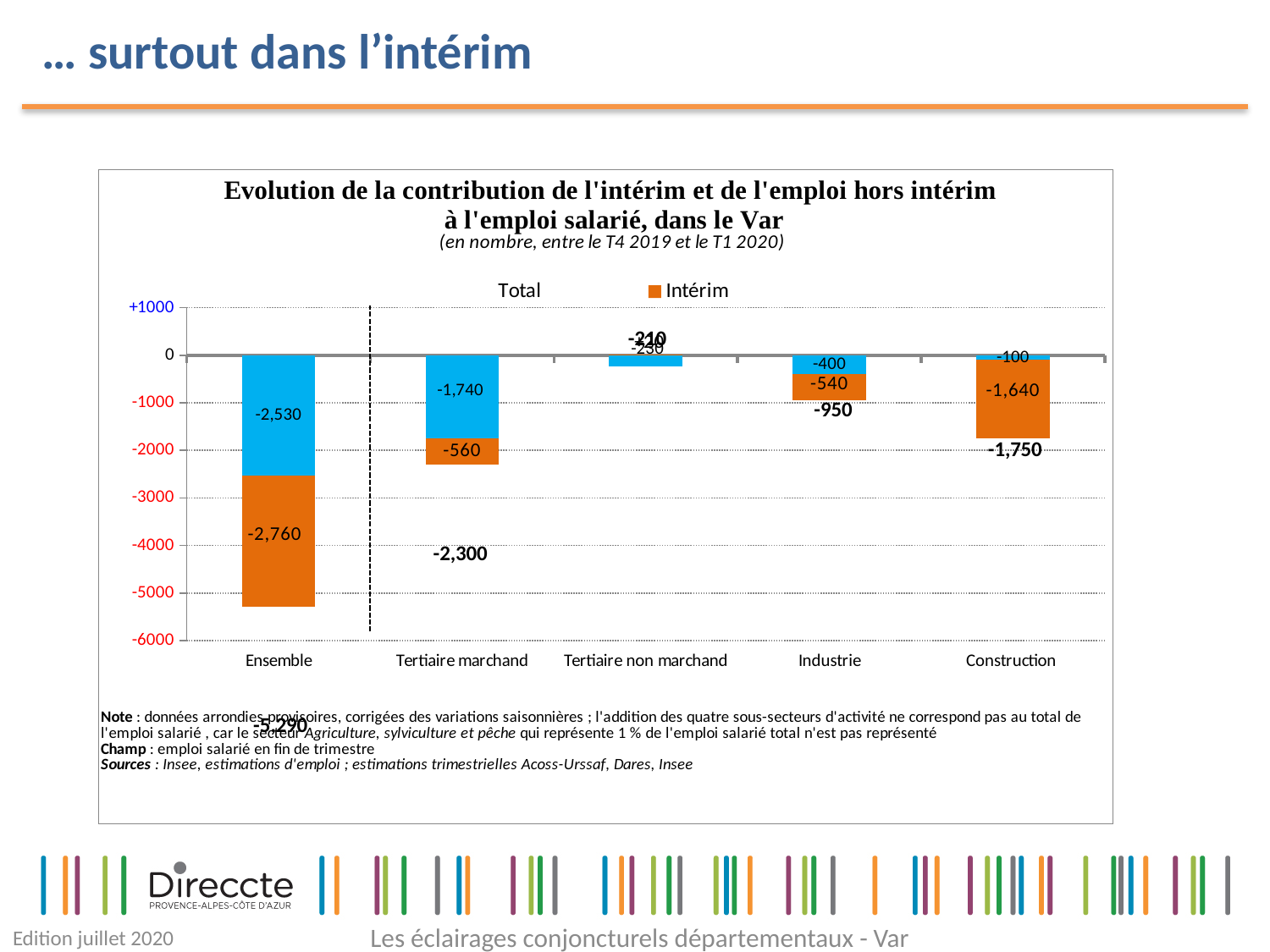
What kind of chart is shown on the slide? bar chart What is the Intérim value for Ensemble? -2,760 What total is shown for Construction? -1,750 How many series does the chart legend list? 2 What total is shown for Industrie? -950 What is the Intérim value for Tertiaire marchand? -560 What is the Intérim value for Industrie? -540 Which category has the most negative Intérim value? Ensemble What is the difference between the Intérim values for Construction and Industrie? 1,100 What total is shown for Tertiaire marchand? -2,300 How many categories are shown on the x axis of the chart? 5 What is the Intérim value for Construction? -1,640